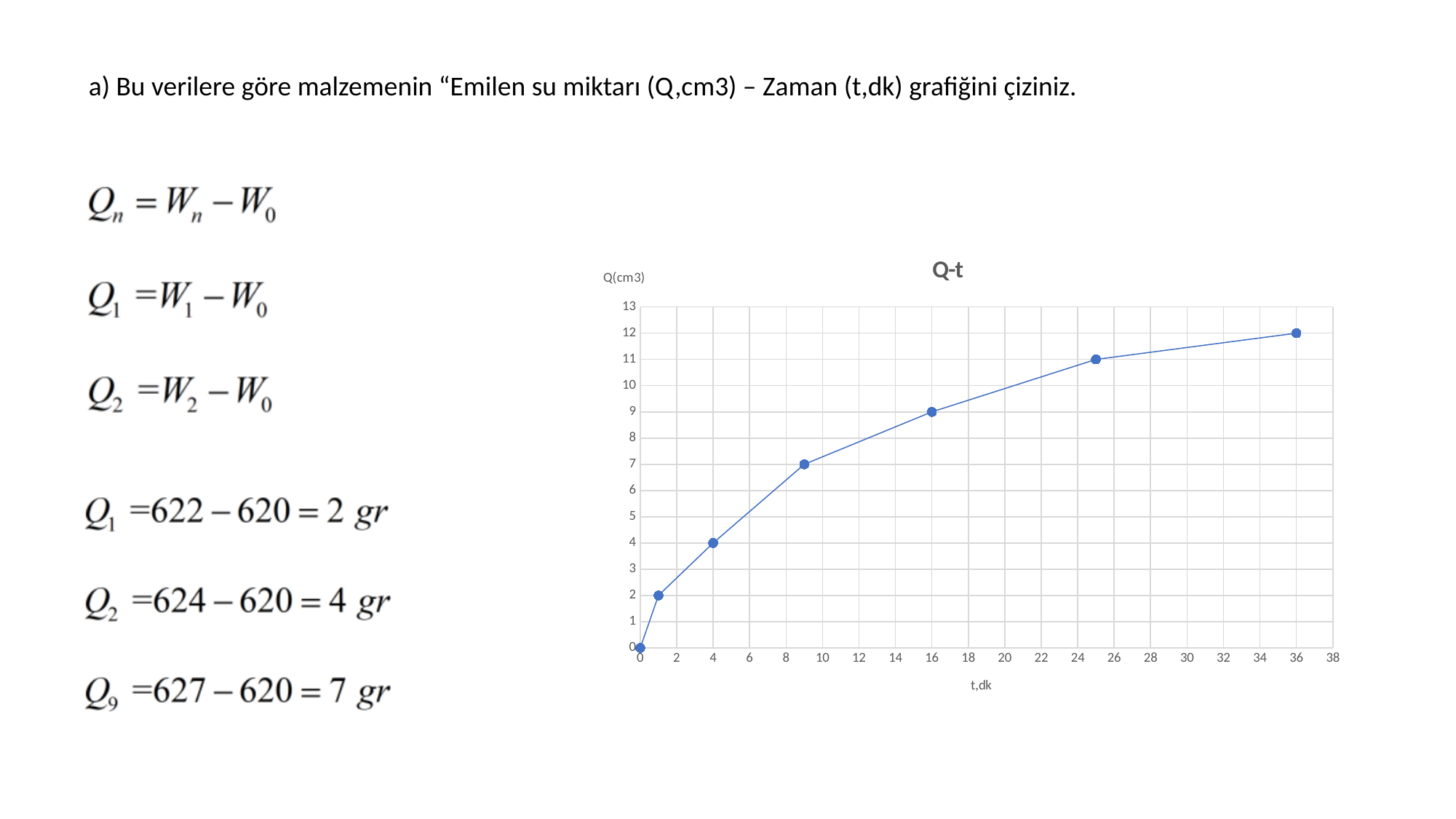
What is the value of Q at t = 16 on the chart? 9 Which is larger, the Q value at t = 4 or at t = 16? t = 16 What is the value of Q at t = 4 on the chart? 4 How many data points are plotted on the chart? 7 What is the highest Q value plotted on the chart? 12 What is the title of the chart? Q-t What is the value of Q at t = 36 on the chart? 12 What kind of chart is shown on the slide? line chart What is the lowest Q value plotted on the chart? 0 What is the difference between the Q values at t = 36 and t = 16? 3 What is the label of the horizontal axis of the chart? t,dk Do the values on the chart rise or fall as t increases? rise